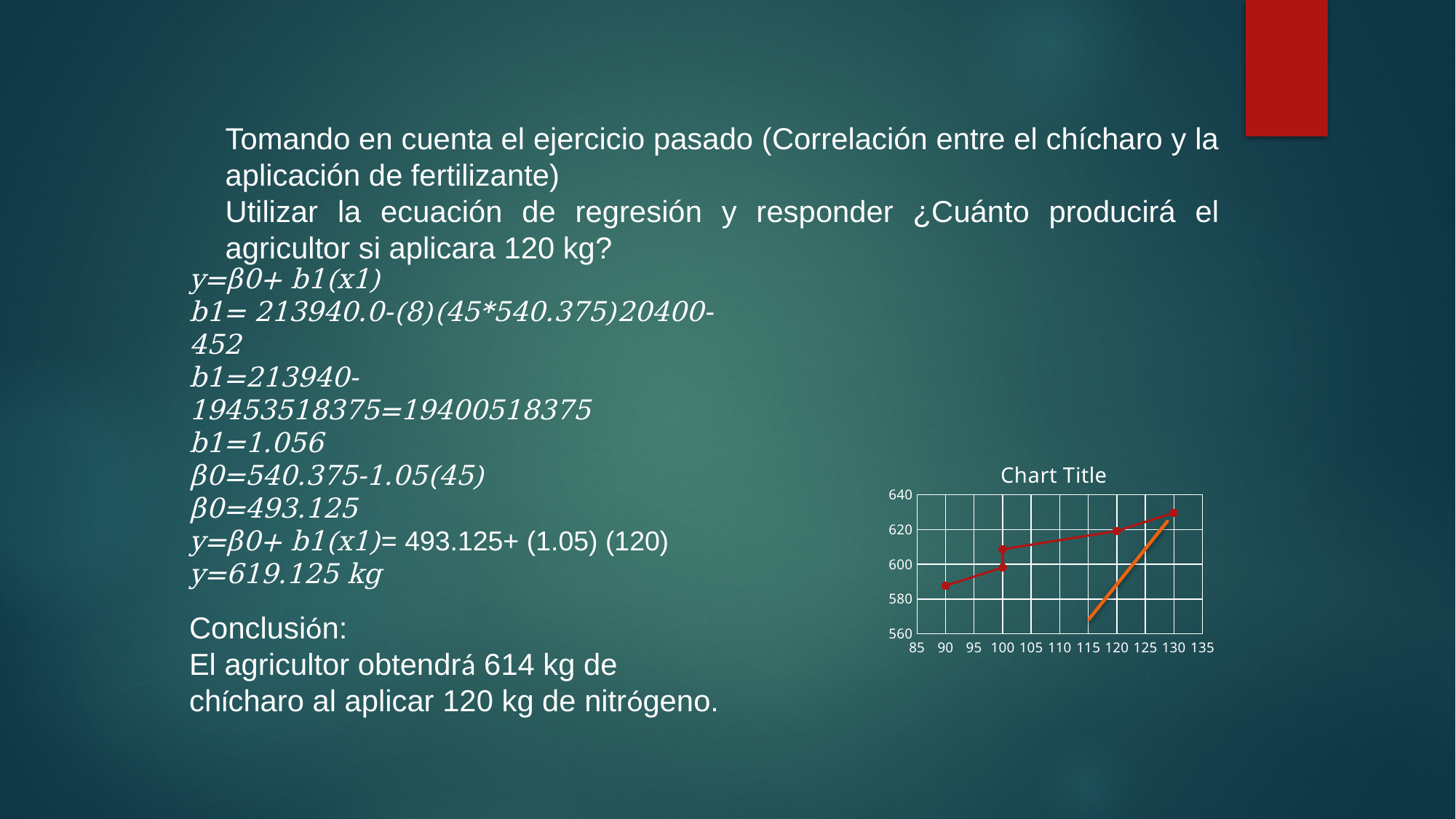
What is the lowest value shown on the chart's y axis? 560 At which x value does the red series reach its highest point? 130 How many red data points are plotted on the chart? 5 Do the red plotted values rise or fall as the x axis increases? rise Is the red series value at x = 130 greater or less than 620? greater At which x value does the red series have its lowest point? 90 What kind of chart is shown on the slide? line chart What is the title of the chart on the slide? Chart Title Is the red series value at x = 90 greater or less than 600? less Is the red series value at x = 90 greater or less than 580? greater Which is larger, the red series value at x = 130 or at x = 90? x = 130